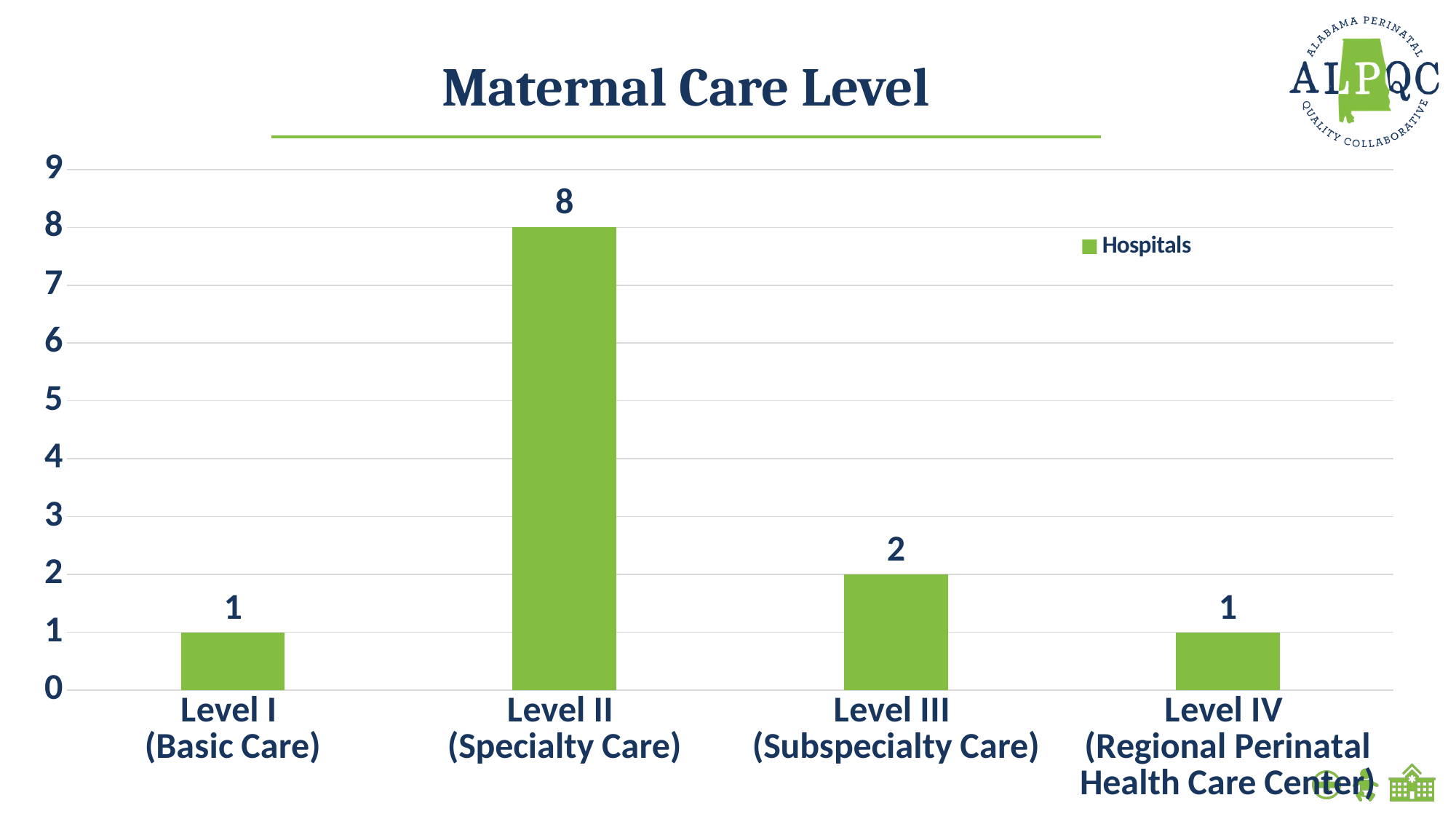
Which maternal care level has the highest number of hospitals? Level II (Specialty Care) How many hospitals are shown for Level II (Specialty Care)? 8 How many series does the legend list? 1 Which has more hospitals, Level III or Level IV? Level III What is the name of the series in the legend? Hospitals What is the difference in the number of hospitals between Level II and Level III? 6 What kind of chart is shown on the slide? Bar chart What is the title of the chart? Maternal Care Level How many maternal care levels are shown on the x axis? 4 How many hospitals are shown for Level III (Subspecialty Care)? 2 Is the value for Level II greater or less than 5? greater How many hospitals are shown for Level I (Basic Care)? 1